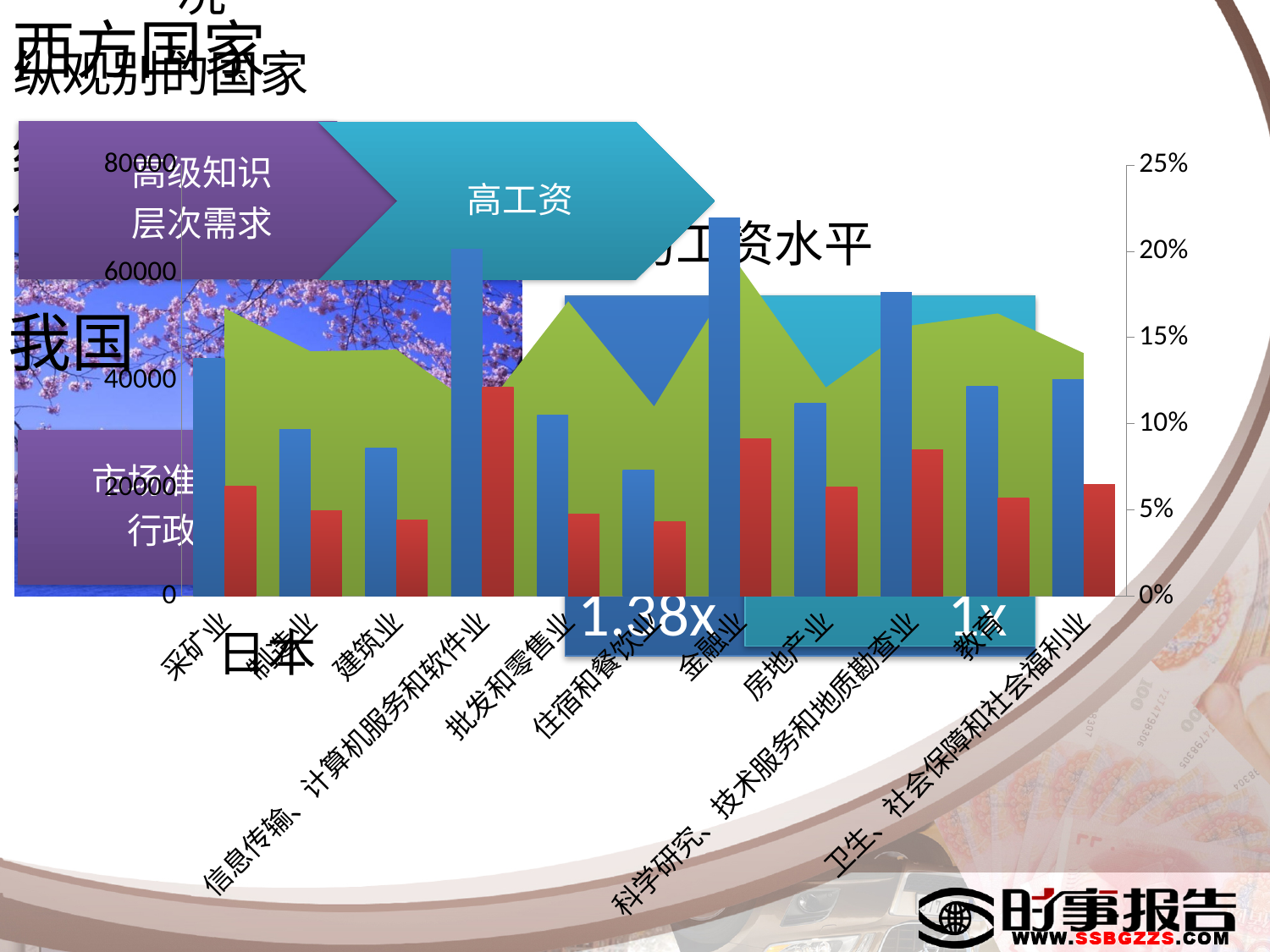
Which category has the tallest red bar? 信息传输、计算机服务和软件业 How many categories are shown on the x axis of the chart? 11 Is the blue bar for 建筑业 greater or less than 40000? less Which is larger, the red bar for 信息传输、计算机服务和软件业 or the red bar for 采矿业? 信息传输、计算机服务和软件业 Is the red bar for 住宿和餐饮业 greater or less than 20000? less Is the red bar for 信息传输、计算机服务和软件业 greater or less than 20000? greater Which is larger, the blue bar for 金融业 or the blue bar for 房地产业? 金融业 Which category has the tallest blue bar? 金融业 What is the maximum value shown on the left-hand axis? 80000 What is the maximum value shown on the right-hand percentage axis? 25%